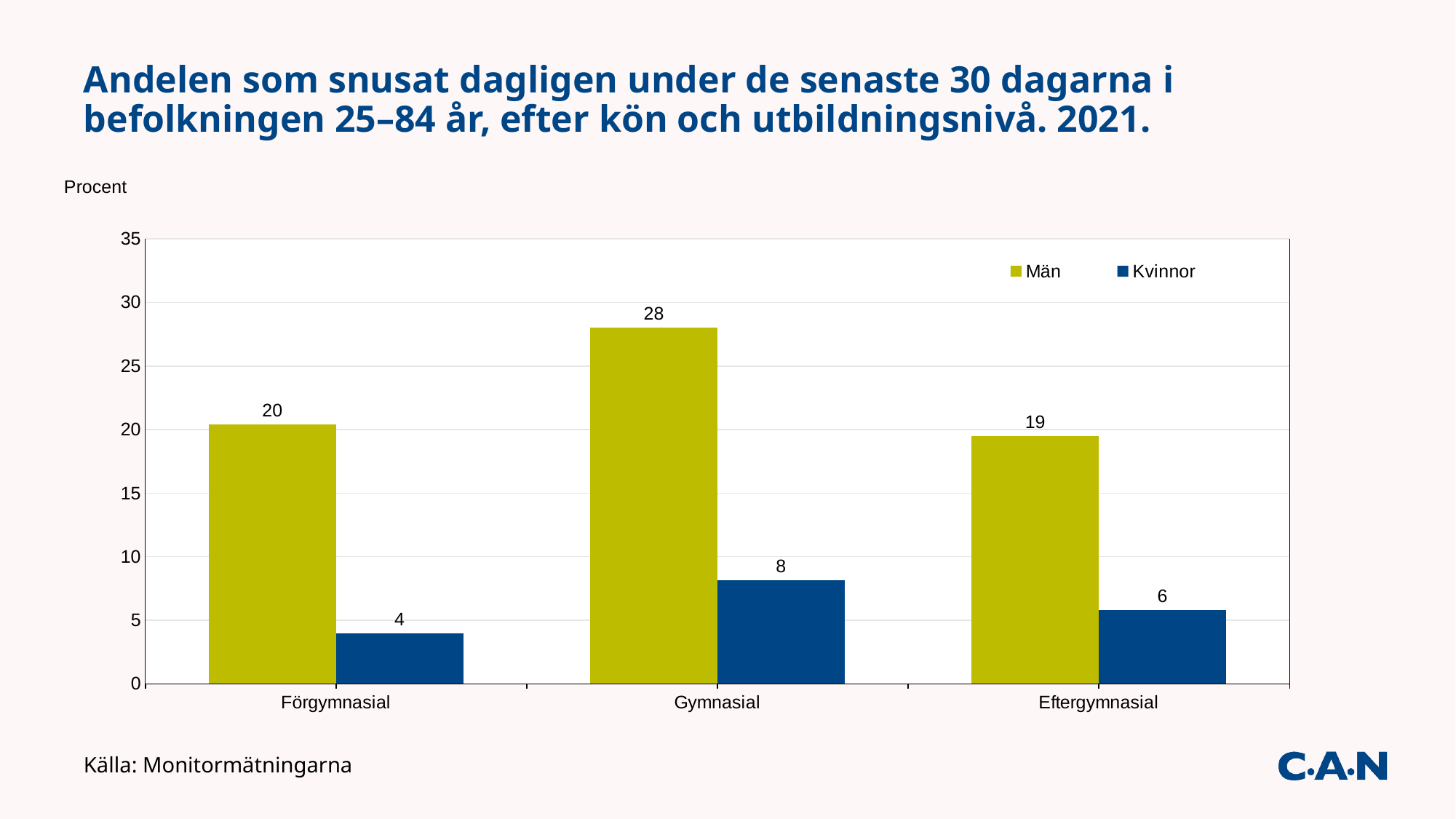
Is the value for Kvinnor in the Gymnasial category greater or less than 10? less What is the value for Kvinnor in the Förgymnasial category? 4 Which is larger: the Män value for Förgymnasial or the Män value for Eftergymnasial? Förgymnasial What is the difference between the Män and Kvinnor values in the Gymnasial category? 20 How many series does the legend list? 2 What is the value for Män in the Gymnasial category? 28 Which education level has the highest value for Män? Gymnasial What unit is shown on the y axis label? Procent What is the value for Kvinnor in the Eftergymnasial category? 6 How many education level categories are shown on the x axis? 3 Which education level has the lowest value for Kvinnor? Förgymnasial What kind of chart is shown on the slide? bar chart